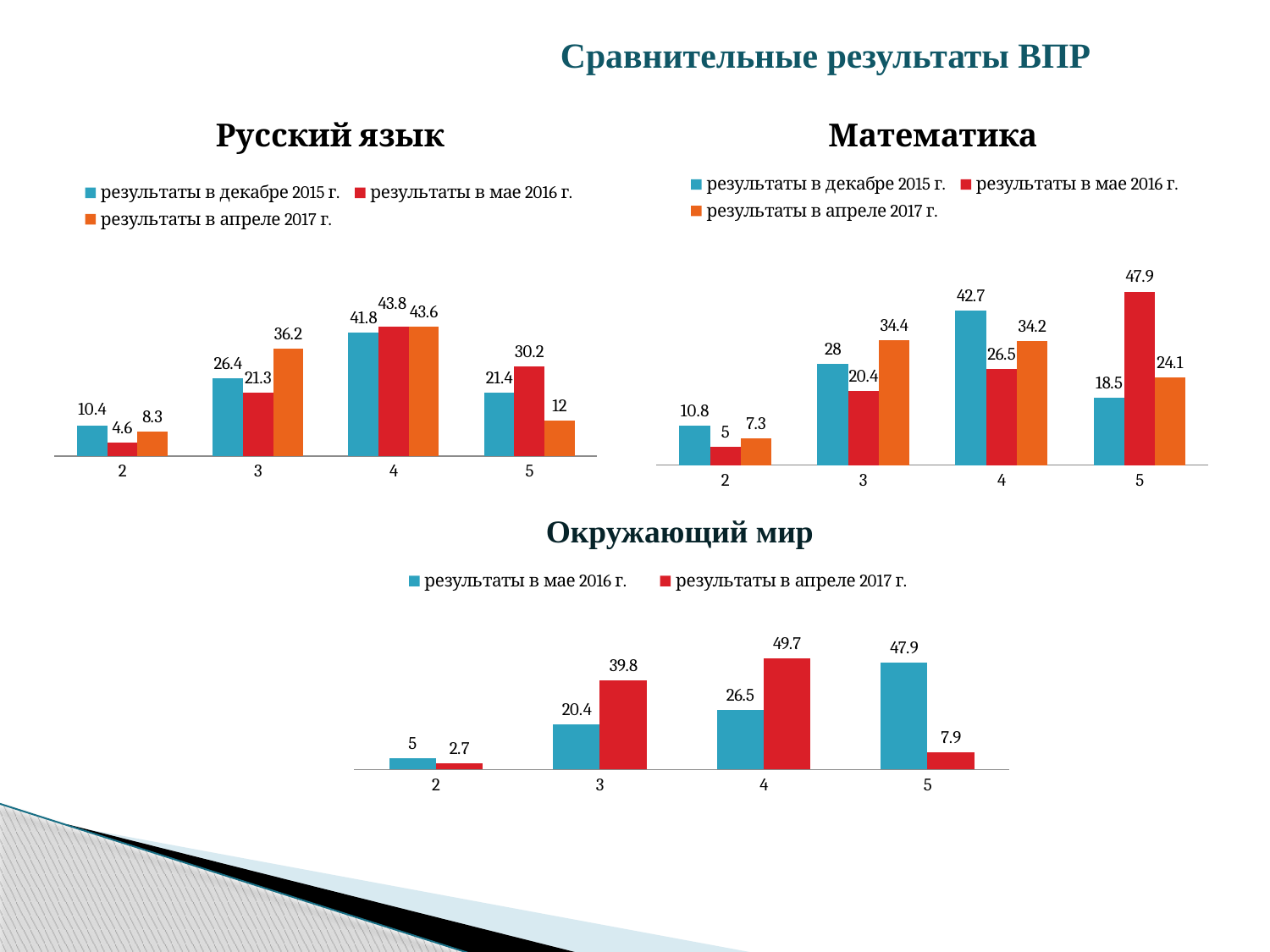
In the "Русский язык" chart, what is the value for category 3 in the series "результаты в апреле 2017 г."? 36.2 How many series does the legend of the "Окружающий мир" chart list? 2 What kind of chart is the "Русский язык" chart? Bar chart In the "Математика" chart, what is the value for category 5 in the series "результаты в мае 2016 г."? 47.9 How many categories are shown on the x axis of the "Математика" chart? 4 What is the title of the slide? Сравнительные результаты ВПР In the "Окружающий мир" chart, what is the value for category 4 in the series "результаты в апреле 2017 г."? 49.7 In the "Русский язык" chart, which category has the highest value for "результаты в декабре 2015 г."? 4 In the "Окружающий мир" chart, which category has the lowest value for "результаты в апреле 2017 г."? 2 In the "Окружающий мир" chart, do the values for "результаты в мае 2016 г." rise or fall from category 2 to category 5? Rise In the "Русский язык" chart, which is larger for category 5: "результаты в мае 2016 г." or "результаты в апреле 2017 г."? результаты в мае 2016 г. In the "Математика" chart, what is the difference between the values for category 4 in "результаты в декабре 2015 г." and "результаты в мае 2016 г."? 16.2